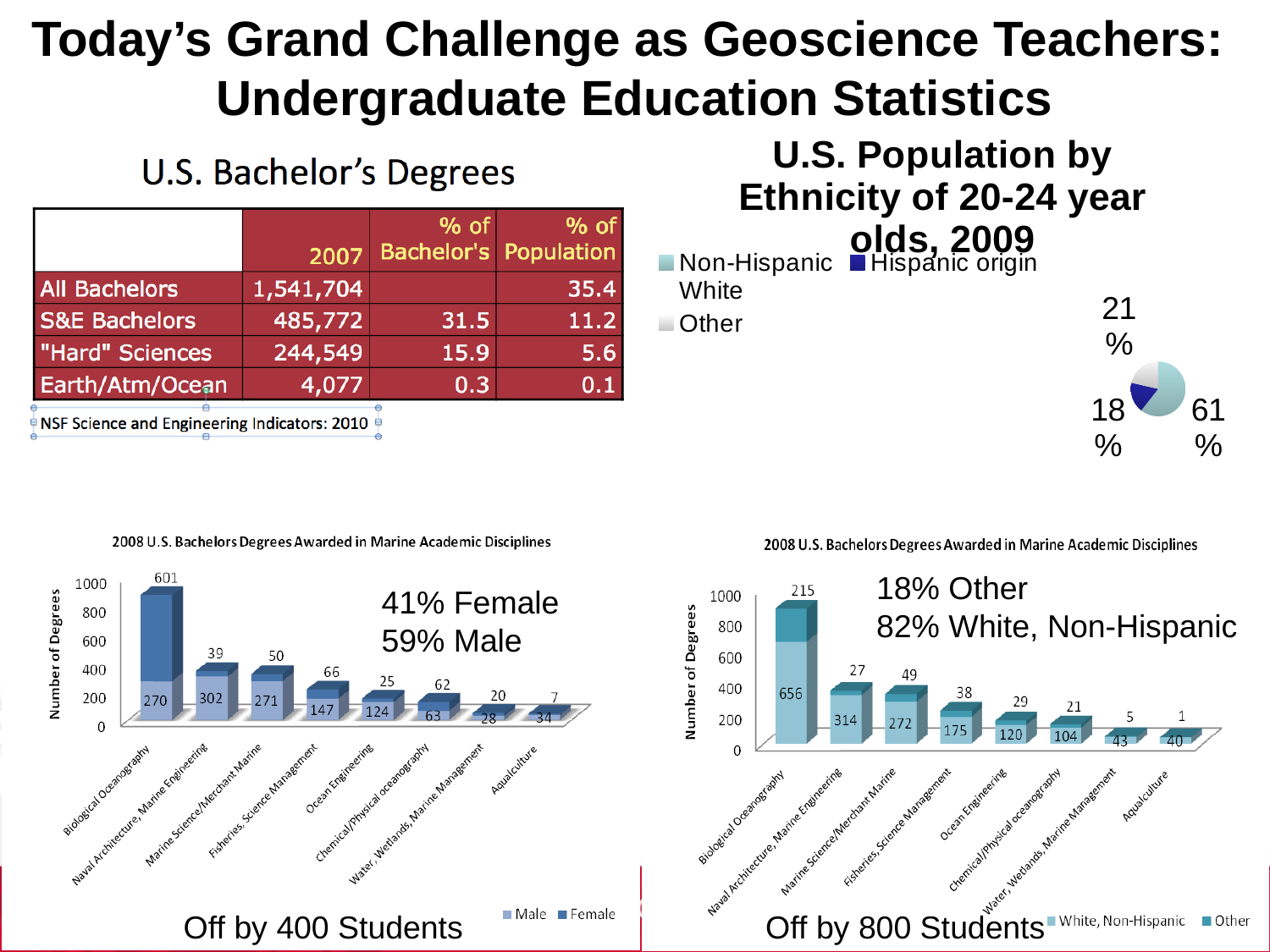
How many disciplines are shown on the x axis of the bottom-left chart (Male/Female)? 8 In the pie chart 'U.S. Population by Ethnicity of 20-24 year olds, 2009', what is the share of the largest slice? 61% In the bottom-right chart (White, Non-Hispanic/Other), which is larger: the White, Non-Hispanic value for Fisheries, Science Management or for Ocean Engineering? Fisheries, Science Management In the bottom-left chart '2008 U.S. Bachelors Degrees Awarded in Marine Academic Disciplines' (Male/Female), what is the Male value for Naval Architecture, Marine Engineering? 302 What kind of chart is the bottom-right chart '2008 U.S. Bachelors Degrees Awarded in Marine Academic Disciplines' (White, Non-Hispanic/Other)? Stacked bar chart How many entries does the legend of the pie chart 'U.S. Population by Ethnicity of 20-24 year olds, 2009' list? 3 In the bottom-left chart (Male/Female), what is the Female value for Biological Oceanography? 601 In the bottom-right chart (White, Non-Hispanic/Other), what is the White, Non-Hispanic value for Biological Oceanography? 656 In the bottom-right chart (White, Non-Hispanic/Other), what is the total of the stacked bar for Marine Science/Merchant Marine? 321 In the bottom-left chart (Male/Female), what is the total of the stacked bar for Fisheries, Science Management? 213 In the bottom-right chart (White, Non-Hispanic/Other), which discipline has the lowest Other value? Aquaculture In the bottom-left chart (Male/Female), what is the difference between the Male and Female values for Ocean Engineering? 99